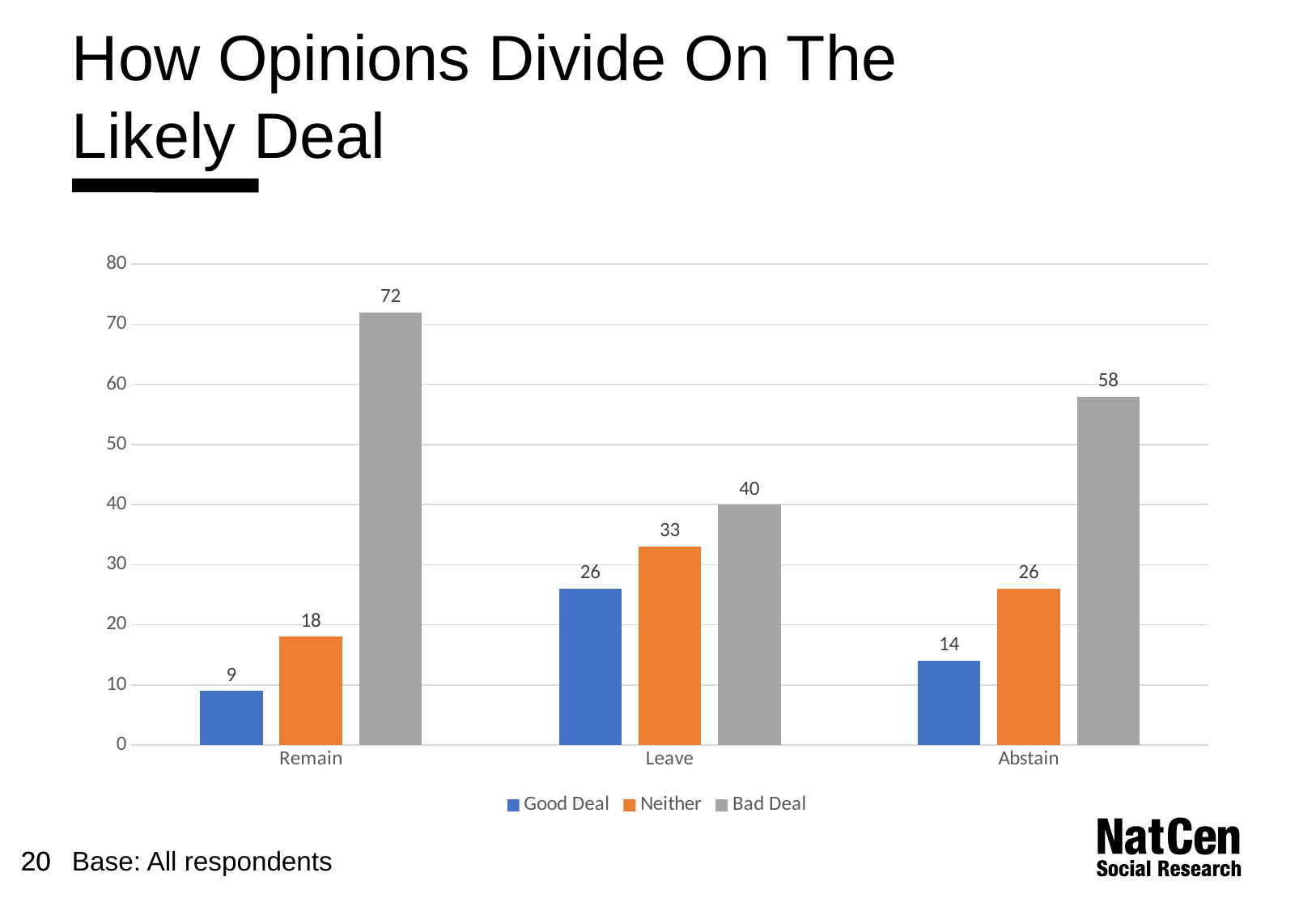
What is the value for Neither in the Abstain category? 26 How many series does the legend list? 3 Which category has the highest Bad Deal value? Remain Which colour represents the Neither series in the legend? orange What kind of chart is shown on the slide? bar chart How many categories are shown on the x axis? 3 Is the Bad Deal value for Abstain greater or less than 50? greater What is the value for Bad Deal in the Remain category? 72 Which is larger: the Neither value for Leave or the Neither value for Remain? Leave Which category has the lowest Good Deal value? Remain What is the difference between the Bad Deal values for Remain and Leave? 32 What is the value for Good Deal in the Leave category? 26